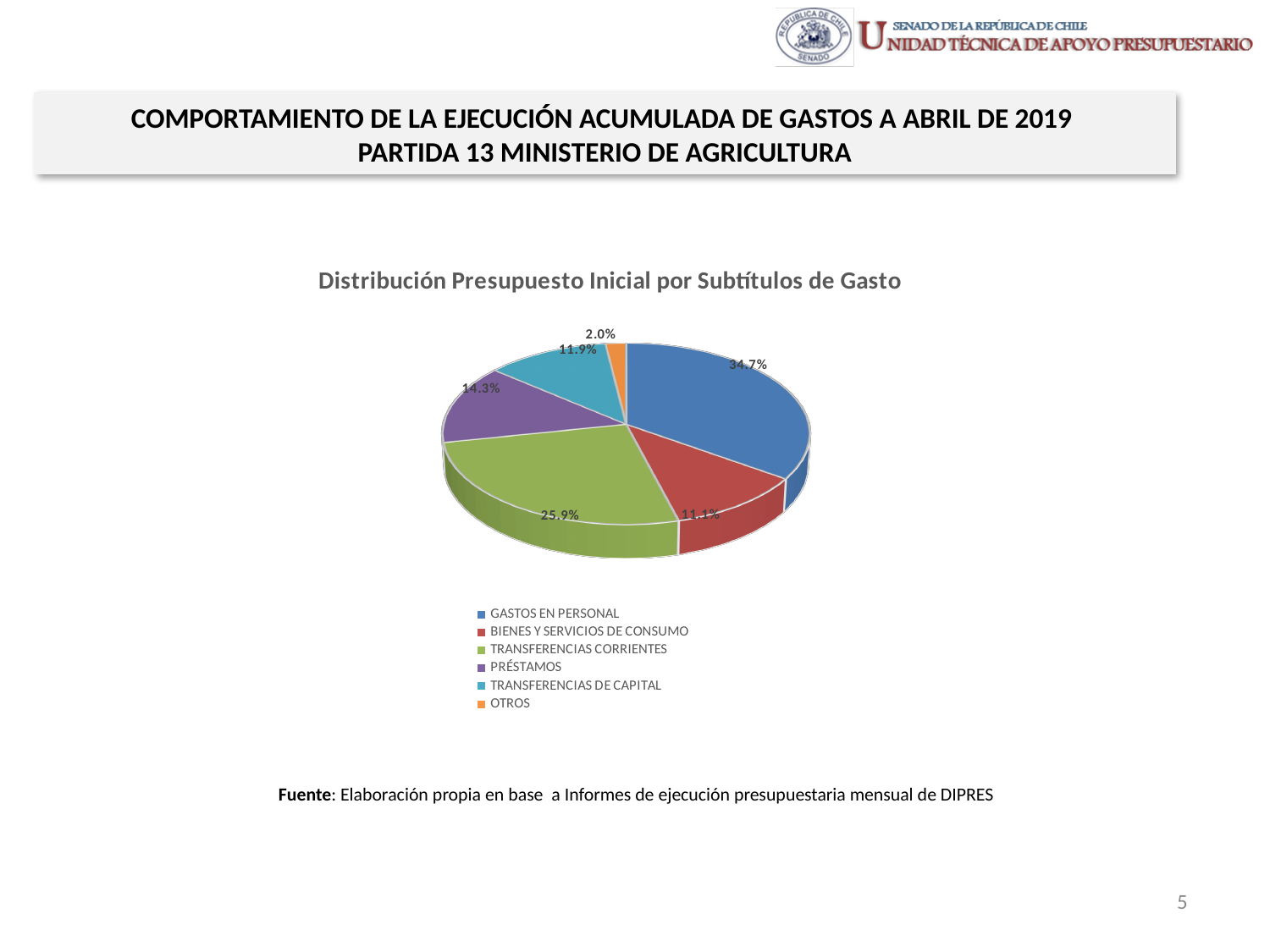
What share of the pie does PRÉSTAMOS represent? 14.3% What colour is the slice for TRANSFERENCIAS CORRIENTES? Green Which is larger, the share for PRÉSTAMOS or the share for TRANSFERENCIAS DE CAPITAL? PRÉSTAMOS Which category has the largest share of the pie? GASTOS EN PERSONAL What is the difference in percentage points between GASTOS EN PERSONAL and TRANSFERENCIAS CORRIENTES? 8.8 What share of the pie does GASTOS EN PERSONAL represent? 34.7% Which category has the smallest share of the pie? OTROS What is the title of the chart? Distribución Presupuesto Inicial por Subtítulos de Gasto How many categories does the legend list? 6 What share of the pie does OTROS represent? 2.0% What kind of chart is shown on the slide? Pie chart